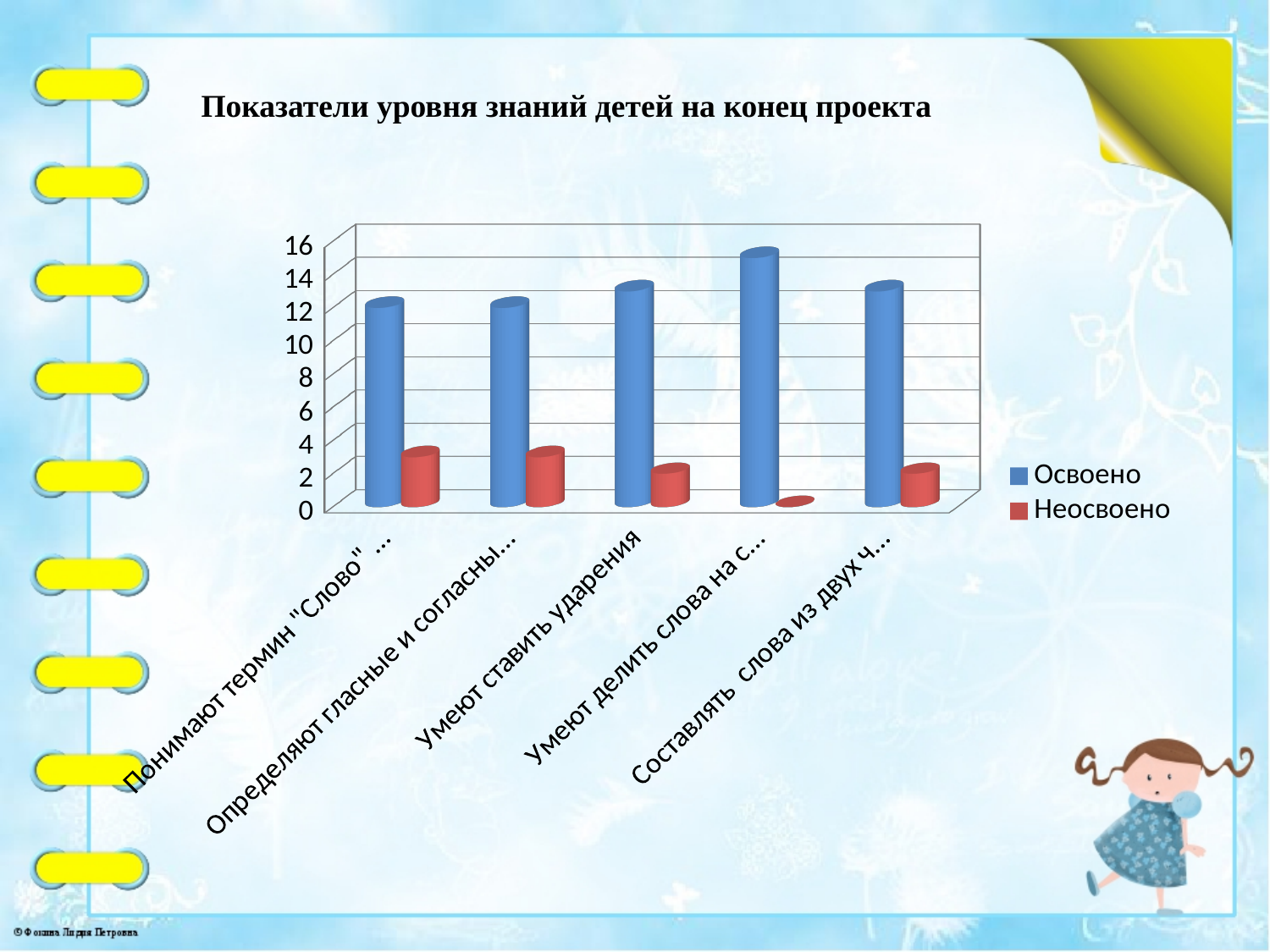
Is the "Неосвоено" value for "Понимают термин "Слово"..." greater or less than 4? less Which colour represents the series "Неосвоено" in the legend? red How many categories are shown on the x axis? 5 Is the "Освоено" value for "Умеют ставить ударения" greater or less than 10? greater What kind of chart is shown on the slide? bar chart Which is larger: the "Освоено" value for "Умеют делить слова на с..." or for "Понимают термин "Слово"..."? Умеют делить слова на с... Which category has the highest value for "Освоено"? Умеют делить слова на с... What is the title of the chart? Показатели уровня знаний детей на конец проекта Which category has the lowest value for "Неосвоено"? Умеют делить слова на с... How many series does the legend list? 2 Is the "Освоено" value for "Умеют делить слова на с..." greater or less than 14? greater For "Составлять слова из двух ч...", which series has the larger value, "Освоено" or "Неосвоено"? Освоено